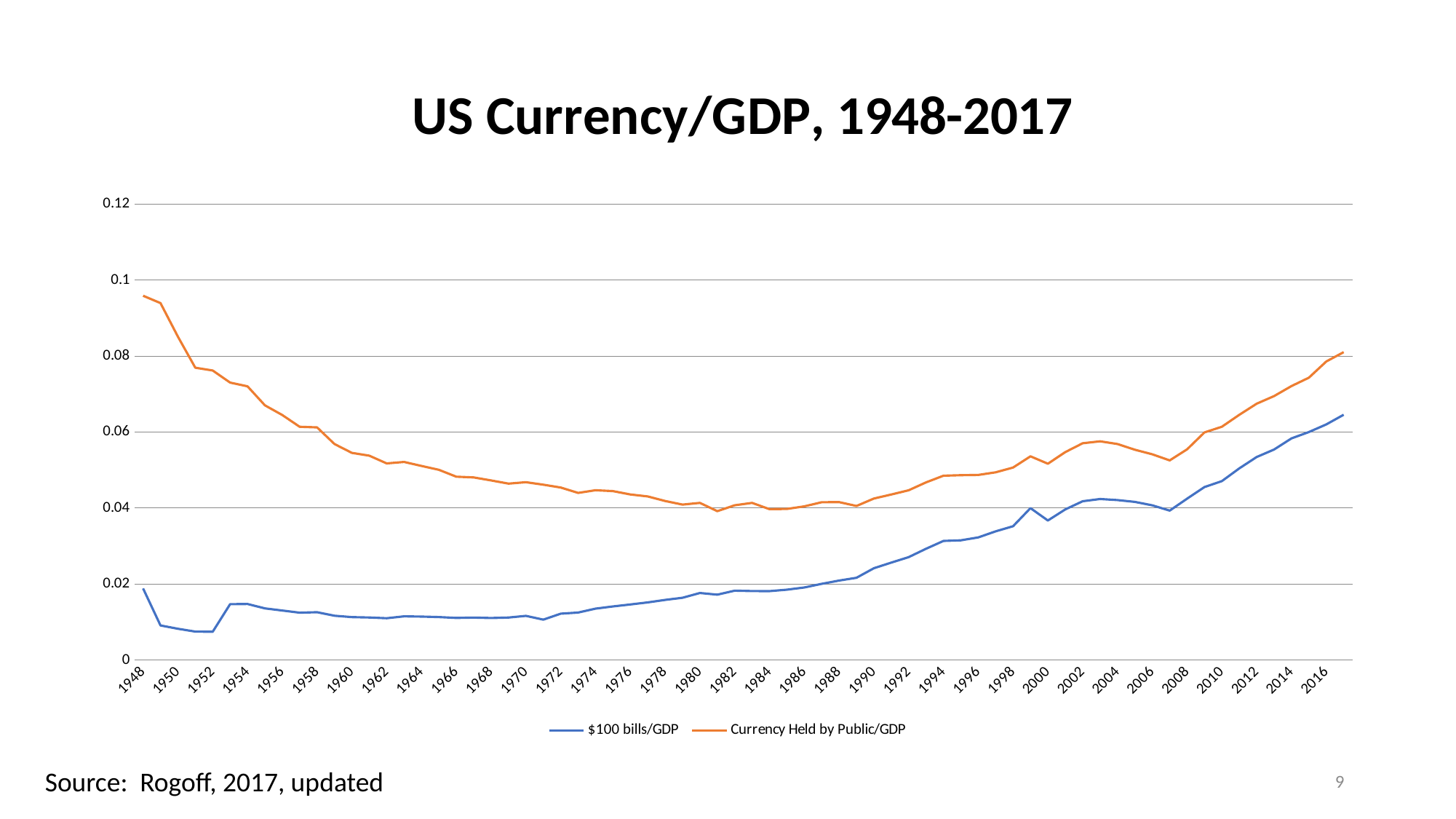
Is the value for $100 bills/GDP in 1952 greater or less than 0.02? less Does $100 bills/GDP rise or fall between 1990 and 2017? rise In which year does Currency Held by Public/GDP reach its highest value? 1948 What kind of chart is shown on the slide? line chart How many series does the legend list? 2 What is the title of the chart? US Currency/GDP, 1948-2017 Is the value for Currency Held by Public/GDP in 1982 greater or less than 0.06? less Does Currency Held by Public/GDP rise or fall between 1948 and 1960? fall Is the value for Currency Held by Public/GDP in 1948 greater or less than 0.08? greater Which series is drawn in orange? Currency Held by Public/GDP In 1948, which series has the higher value, $100 bills/GDP or Currency Held by Public/GDP? Currency Held by Public/GDP